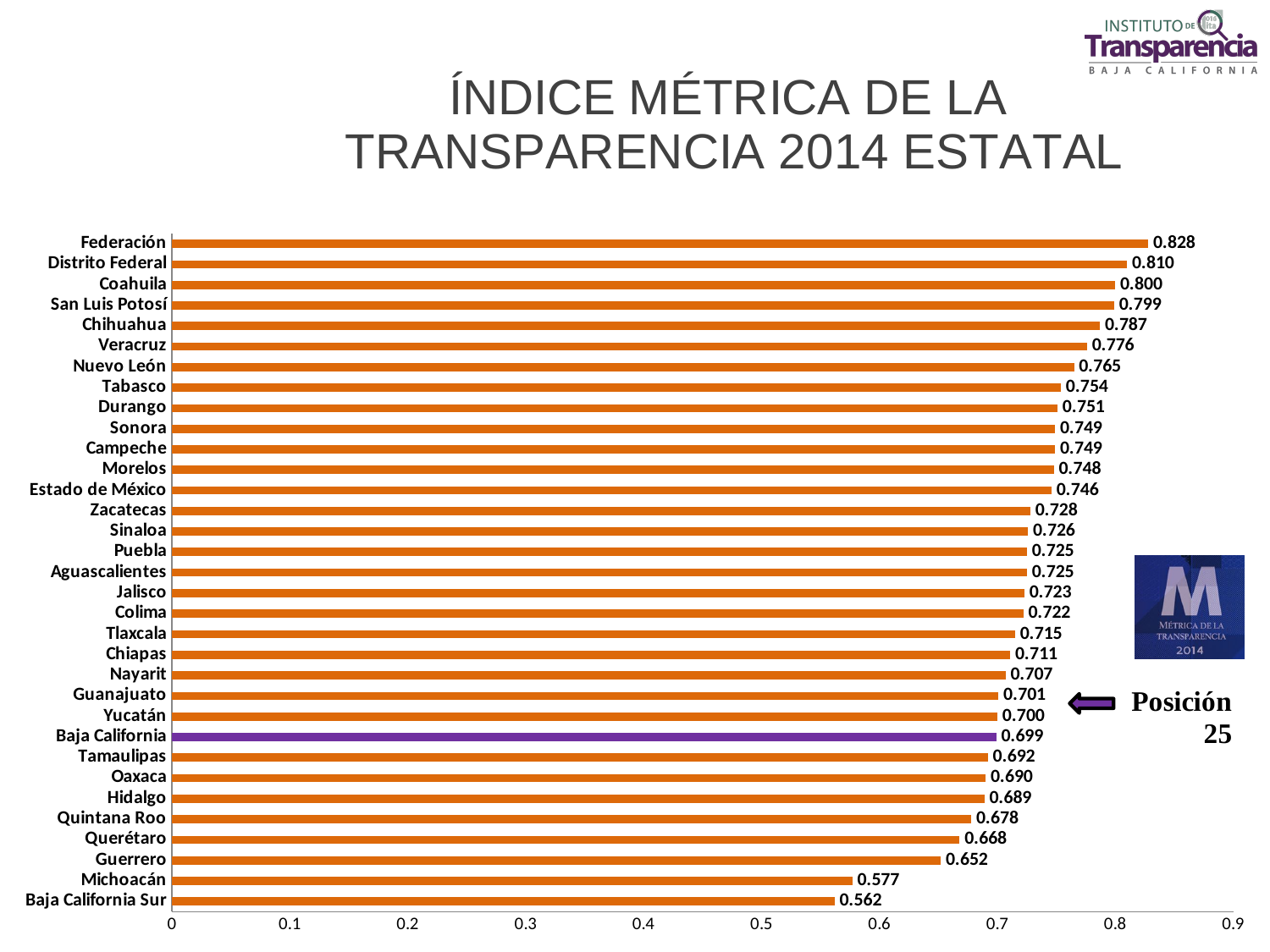
What is the value for Baja California? 0.699 What is the difference between the values for Federación and Baja California Sur? 0.266 How many categories are shown in the chart? 33 Which category has the highest value? Federación What is the value for Michoacán? 0.577 What is the value for Chihuahua? 0.787 What is the difference between the values for Distrito Federal and Coahuila? 0.010 What kind of chart is shown on the slide? bar chart Is the value for Nuevo León greater or less than 0.7? greater Which has a larger value, Guerrero or Querétaro? Querétaro Which category has the lowest value? Baja California Sur Which bar is coloured purple instead of orange? Baja California